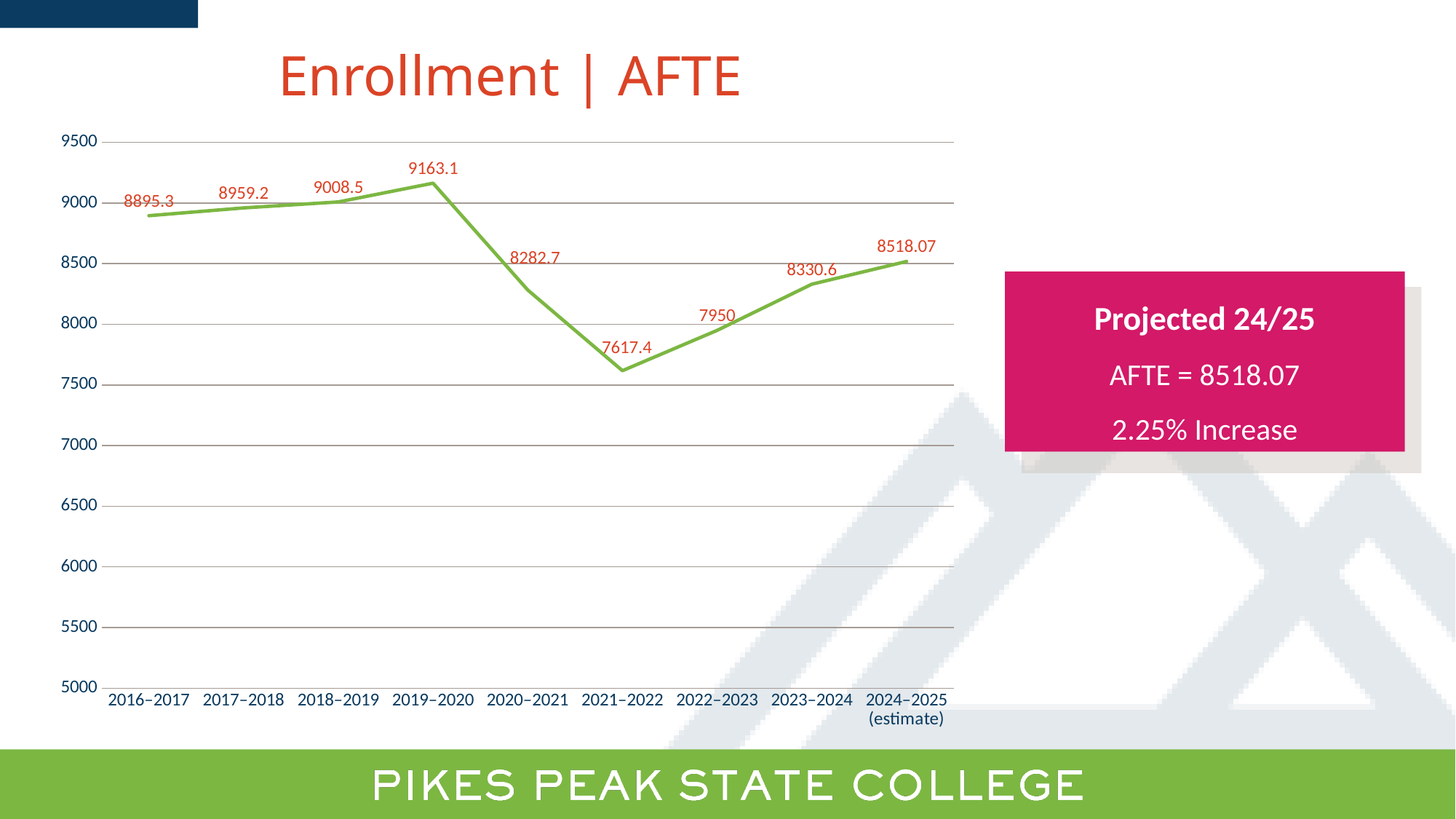
What is the title of the chart? Enrollment | AFTE Which is larger, the AFTE value for 2017–2018 or for 2023–2024? 2017–2018 What is the AFTE value for 2019–2020? 9163.1 What is the AFTE value for 2024–2025 (estimate)? 8518.07 What is the AFTE value for 2021–2022? 7617.4 How many academic years are plotted on the chart? 9 Do the AFTE values rise or fall from 2021–2022 to 2024–2025? Rise Which academic year has the highest AFTE value? 2019–2020 Which academic year has the lowest AFTE value? 2021–2022 What kind of chart is shown on the slide? Line chart What is the AFTE value for 2016–2017? 8895.3 What is the difference between the AFTE values for 2019–2020 and 2021–2022? 1545.7